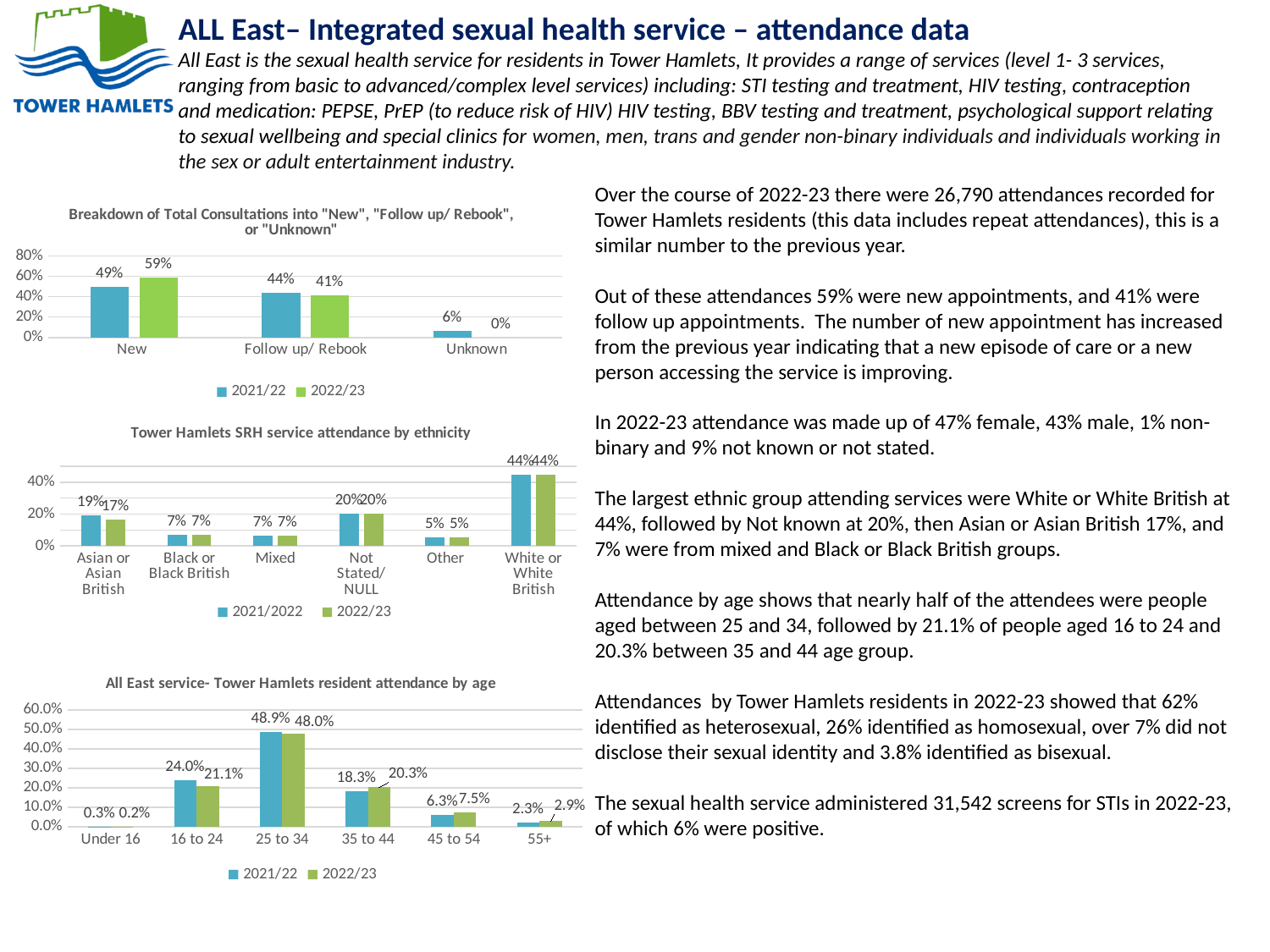
In the chart 'Tower Hamlets SRH service attendance by ethnicity', which category has the lowest value in 2022/23? Other In the chart 'All East service- Tower Hamlets resident attendance by age', which age group has the highest value in 2021/22? 25 to 34 In the chart 'Tower Hamlets SRH service attendance by ethnicity', what is the 2021/2022 value for Asian or Asian British? 19% In the chart 'Breakdown of Total Consultations into "New", "Follow up/ Rebook", or "Unknown"', what is the 2022/23 value for New? 59% In the chart 'Tower Hamlets SRH service attendance by ethnicity', which ethnic group has the highest value in 2022/23? White or White British In the chart 'Breakdown of Total Consultations into "New", "Follow up/ Rebook", or "Unknown"', what is the 2021/22 value for Unknown? 6% In the chart 'All East service- Tower Hamlets resident attendance by age', which is larger for 16 to 24: the 2021/22 value or the 2022/23 value? 2021/22 In the chart 'Tower Hamlets SRH service attendance by ethnicity', how many ethnic categories are shown on the x axis? 6 In the chart 'Breakdown of Total Consultations into "New", "Follow up/ Rebook", or "Unknown"', how many series does the legend list? 2 In the chart 'Breakdown of Total Consultations into "New", "Follow up/ Rebook", or "Unknown"', what is the difference between the 2022/23 and 2021/22 values for New? 10% In the chart 'All East service- Tower Hamlets resident attendance by age', what is the 2022/23 value for 35 to 44? 20.3% What type of chart is 'All East service- Tower Hamlets resident attendance by age'? Bar chart